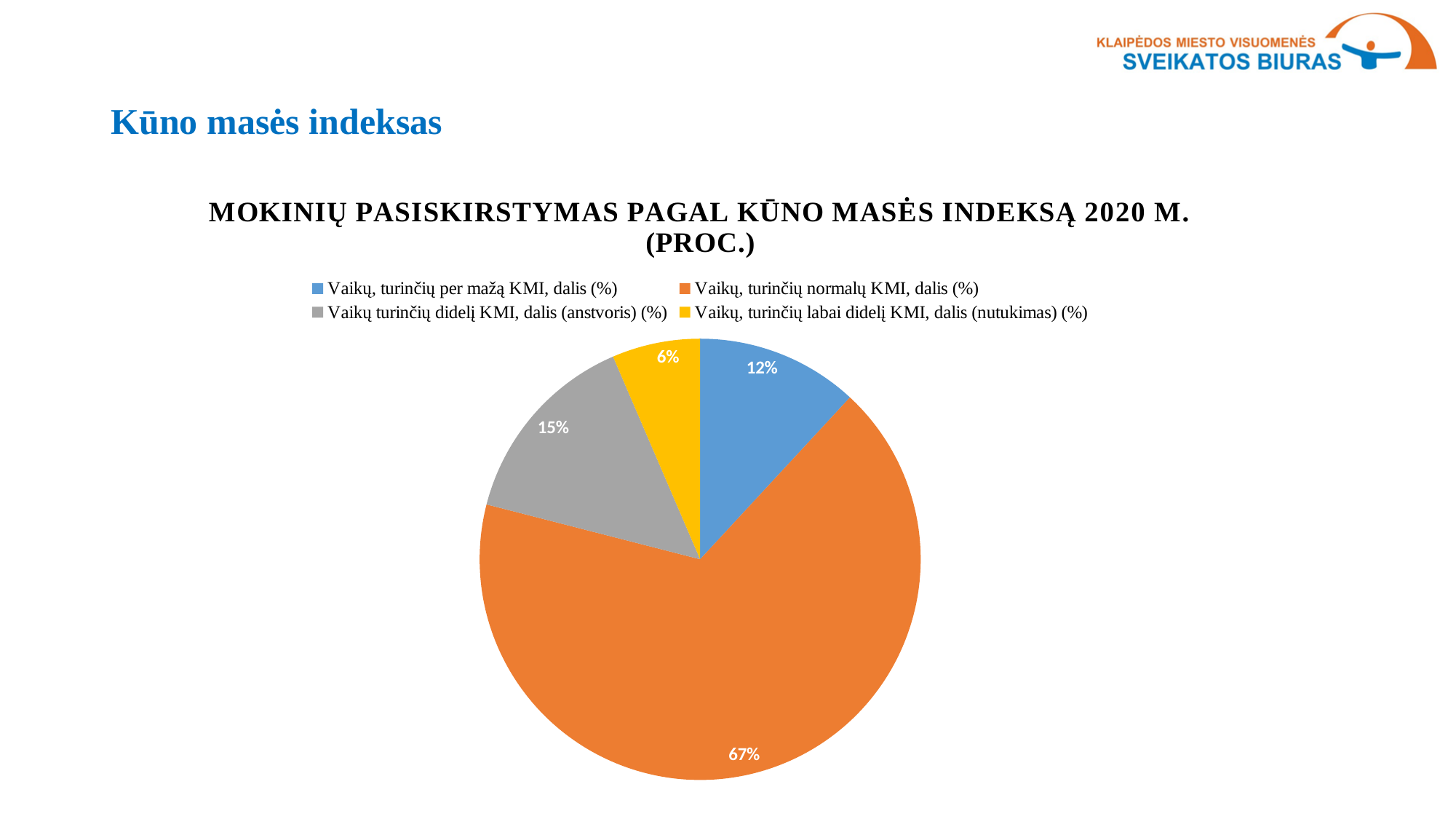
Which is larger: the share of overweight pupils (anstvoris) or the share of pupils with too low BMI? overweight pupils (anstvoris), 15% What share of pupils have too low a BMI (Vaikų, turinčių per mažą KMI)? 12% What share of pupils have a normal BMI (Vaikų, turinčių normalų KMI)? 67% Which category has the smallest slice of the pie? Vaikų, turinčių labai didelį KMI, dalis (nutukimas) (%) What colour is the slice for pupils with normal BMI? orange What is the difference between the share with normal BMI and the share with too low BMI? 55% What share of pupils are overweight (Vaikų turinčių didelį KMI, anstvoris)? 15% How many entries does the legend list? 4 What share of pupils are obese (Vaikų, turinčių labai didelį KMI, nutukimas)? 6% How many slices does the pie chart have? 4 What kind of chart is shown on the slide? pie chart Which category has the largest slice of the pie? Vaikų, turinčių normalų KMI, dalis (%)